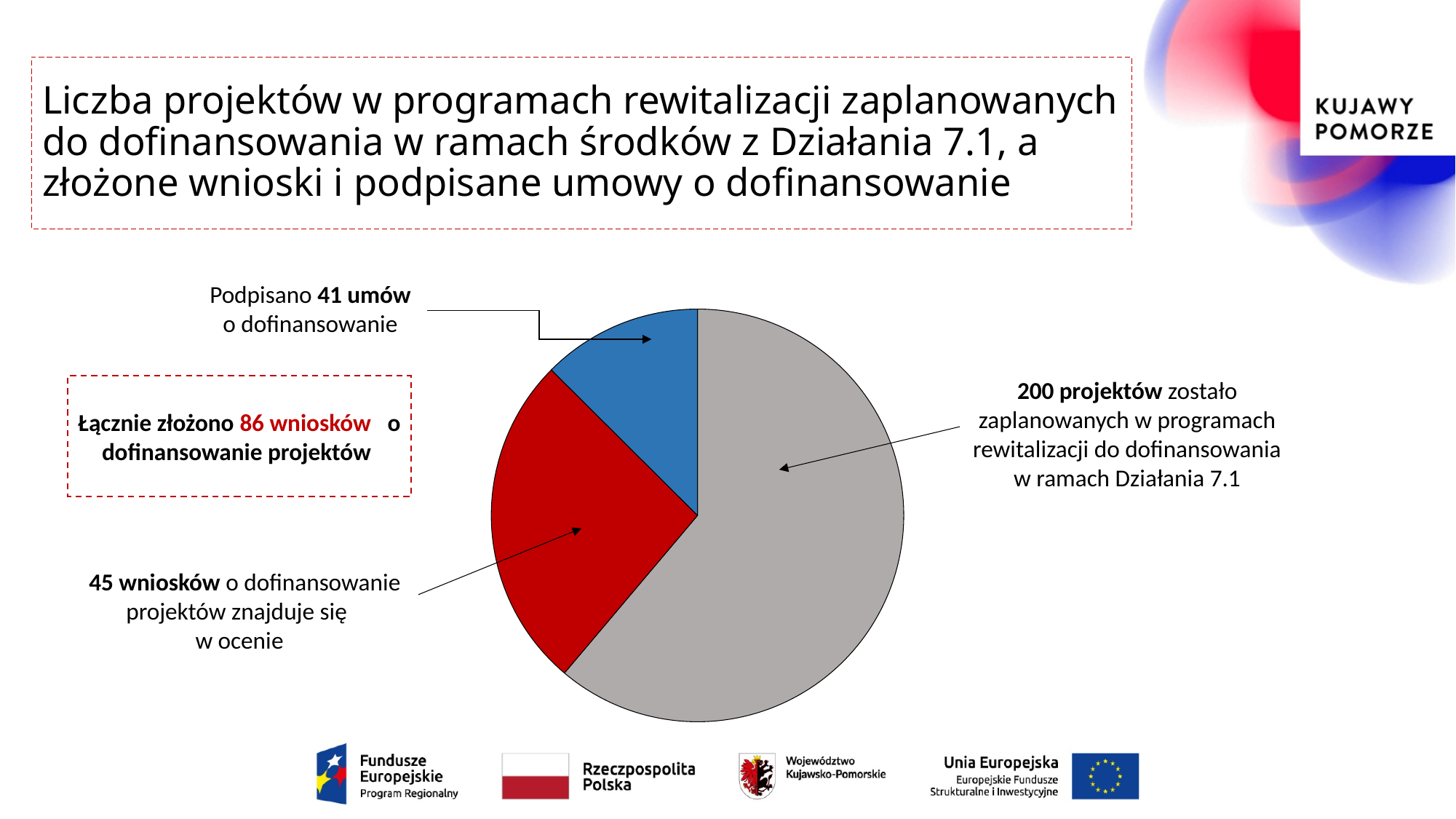
Which slice of the pie chart is the largest? 200 projektów zaplanowanych w programach rewitalizacji What colour is the slice representing the 45 applications under evaluation? red Which slice of the pie chart is the smallest? Podpisano 41 umów o dofinansowanie What colour is the slice representing the 41 signed funding agreements? blue How many funding agreements (umów o dofinansowanie) have been signed, according to the chart label? 41 umów How many projects were planned in the revitalisation programmes for funding under Działanie 7.1, according to the chart label? 200 projektów How many applications for project funding were submitted in total (Łącznie złożono)? 86 wniosków How many applications for project funding are under evaluation (w ocenie), according to the chart label? 45 wniosków What is the difference between the number of applications under evaluation (45) and the number of signed agreements (41)? 4 How many slices does the pie chart have? 3 What kind of chart is shown on the slide? pie chart Which is larger: the number of applications under evaluation or the number of signed agreements? applications under evaluation (45)